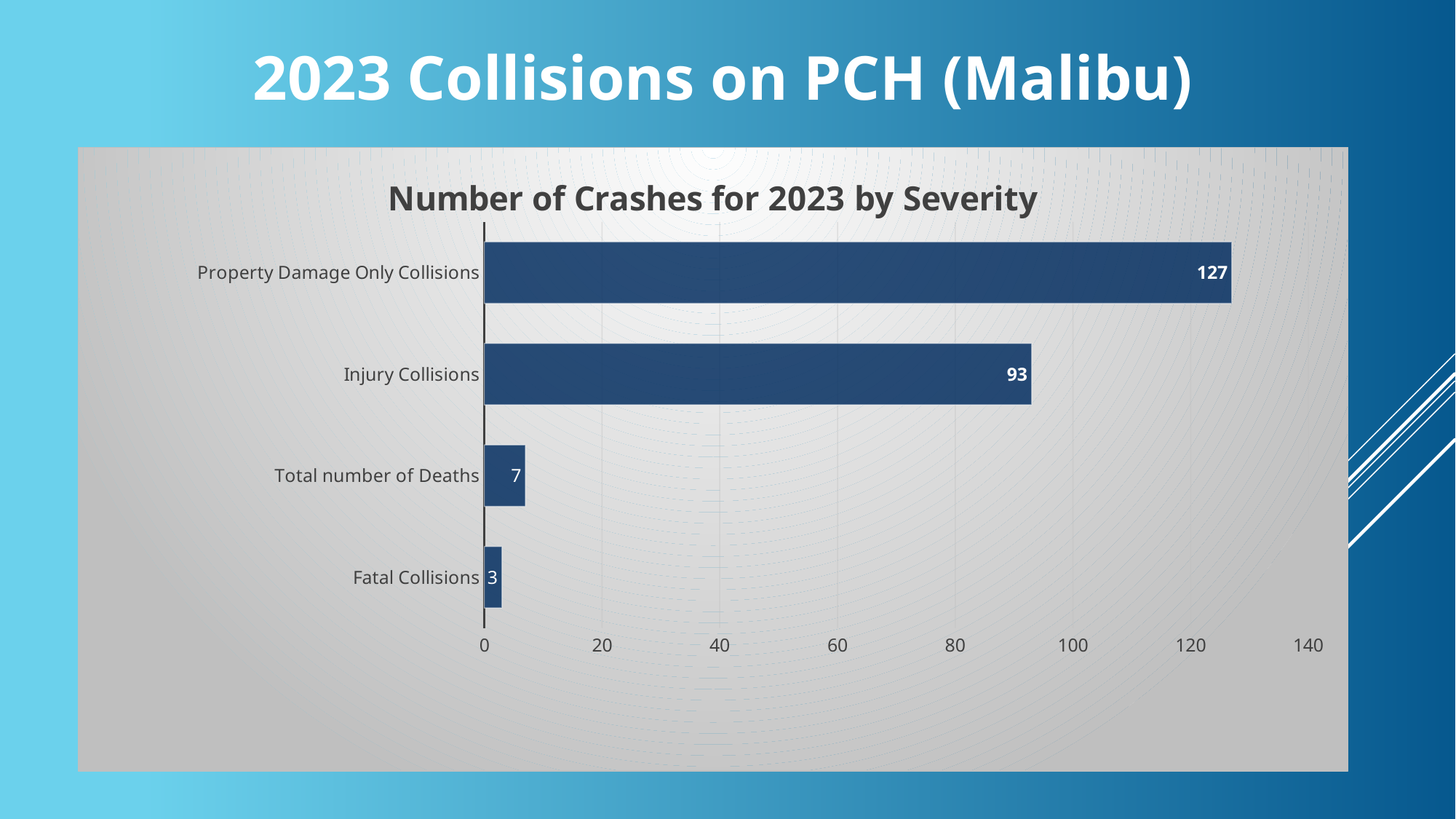
What is the difference between Property Damage Only Collisions and Injury Collisions? 34 Which category has the lowest value? Fatal Collisions What is the difference between Total number of Deaths and Fatal Collisions? 4 What is the value for Total number of Deaths? 7 Which is larger, Injury Collisions or Total number of Deaths? Injury Collisions Is the value for Injury Collisions greater or less than 100? less How many categories are shown in the chart? 4 What type of chart is shown on the slide? bar chart What is the value for Property Damage Only Collisions? 127 What is the value for Fatal Collisions? 3 Which category has the highest value? Property Damage Only Collisions What is the value for Injury Collisions? 93